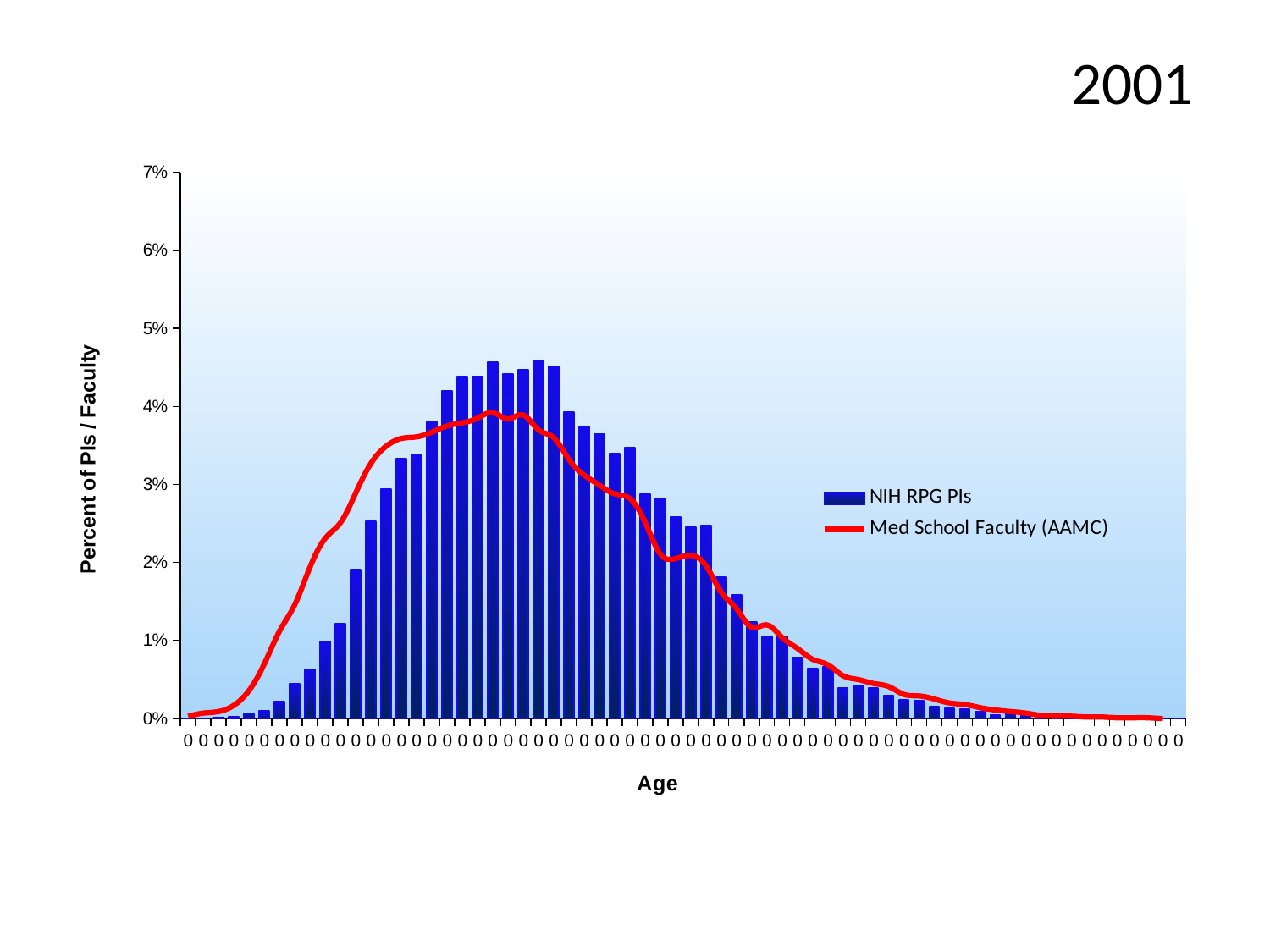
Do the NIH RPG PIs bars rise or fall along the right-hand half of the x axis? fall What is the label on the vertical axis? Percent of PIs / Faculty Is the tallest NIH RPG PIs bar greater or less than 4%? greater Is the peak of the Med School Faculty (AAMC) line greater or less than 5%? less How many series does the legend list? 2 Is the peak of the Med School Faculty (AAMC) line greater or less than 3%? greater What kind of chart is shown on the slide? bar chart with a line overlay What is the highest value shown on the vertical axis? 7% Which series reaches a higher peak value, NIH RPG PIs or Med School Faculty (AAMC)? NIH RPG PIs What are the two series named in the legend? NIH RPG PIs; Med School Faculty (AAMC)